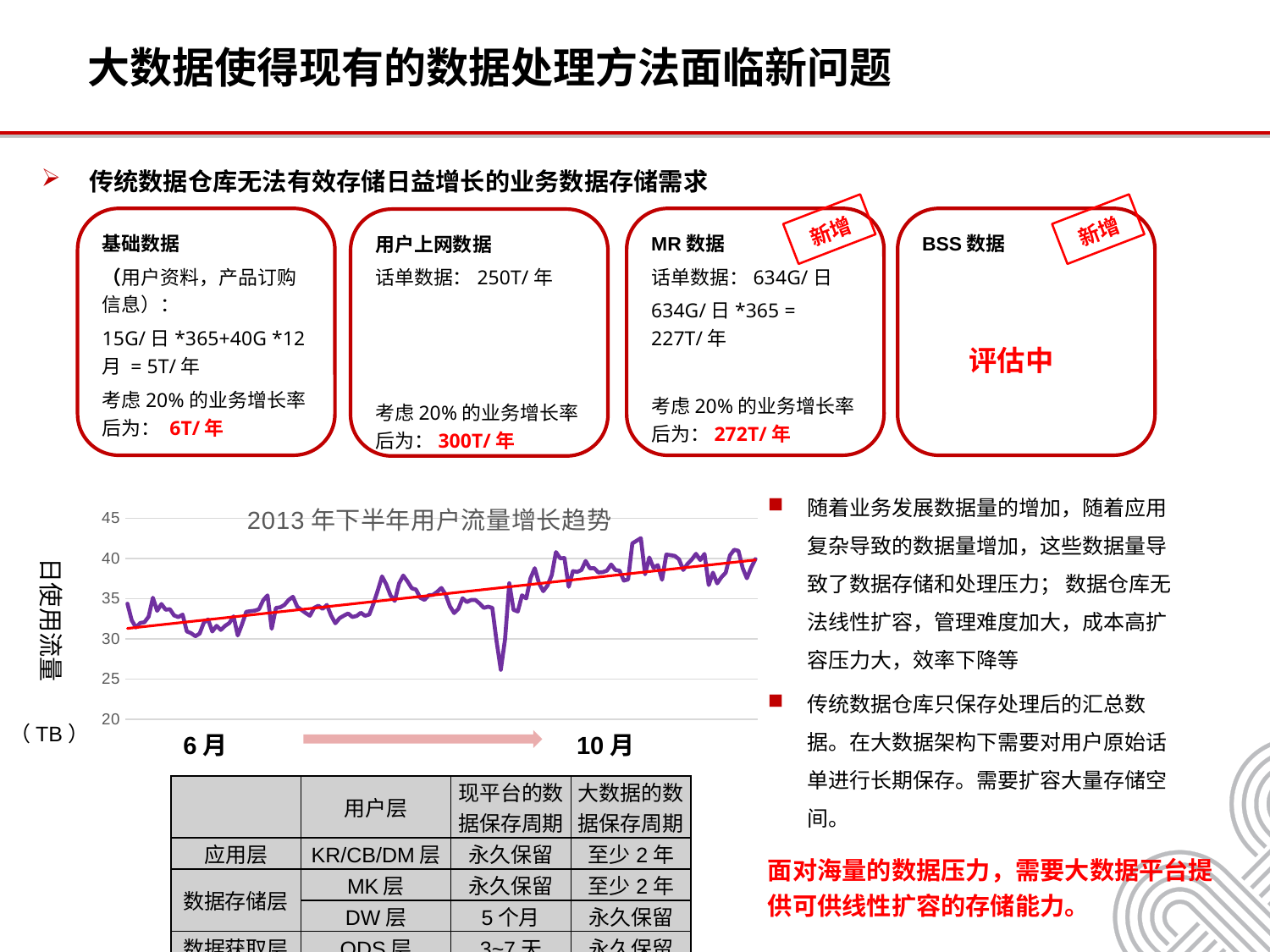
Do the values in the chart generally rise or fall from 6 月 to 10 月? rise What kind of chart is shown on the slide? line chart What is the title of the chart? 2013 年下半年用户流量增长趋势 Is the highest point of the purple line greater or less than 40? greater Is the value at the end of the line (10 月) greater or less than 35? greater Is the lowest point of the purple line greater or less than 30? less What is the label of the vertical axis of the chart? 日使用流量 (TB)